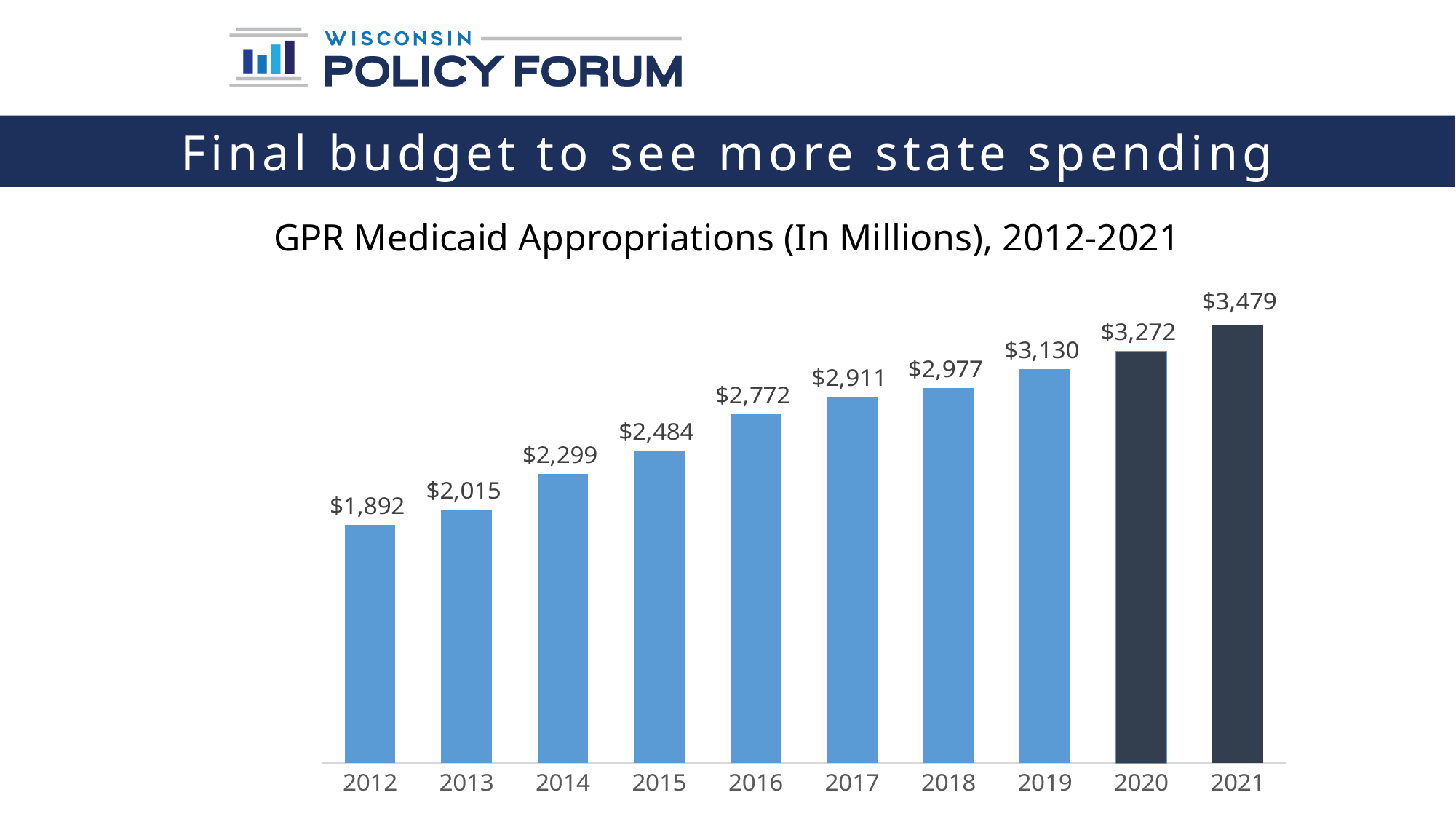
What is the GPR Medicaid appropriation for 2021? $3,479 Which year has the lowest GPR Medicaid appropriation? 2012 What kind of chart is shown on the slide? Bar chart What is the difference between the 2021 and 2020 GPR Medicaid appropriations? $207 Which year has a larger GPR Medicaid appropriation, 2014 or 2018? 2018 What is the GPR Medicaid appropriation for 2012? $1,892 What is the GPR Medicaid appropriation for 2017? $2,911 How many years are shown on the chart? 10 Which years are shown with dark bars instead of light blue bars? 2020 and 2021 Which year has the highest GPR Medicaid appropriation? 2021 Do GPR Medicaid appropriations rise or fall from 2012 to 2021? Rise What is the difference between the 2016 and 2015 GPR Medicaid appropriations? $288